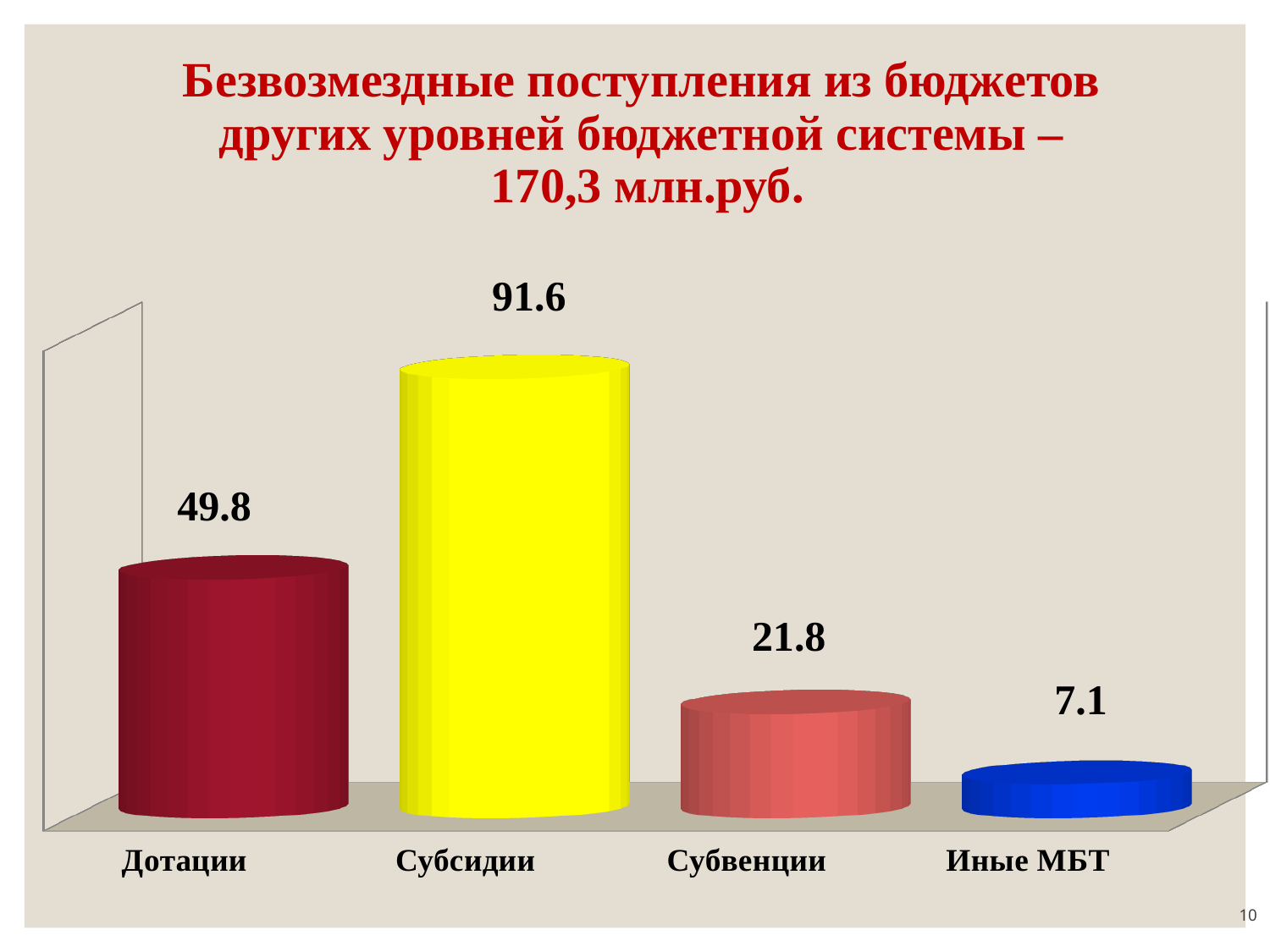
Which category has the highest value? Субсидии What is the value for Субсидии? 91.6 What is the value for Субвенции? 21.8 What kind of chart is shown on the slide? Bar chart Which category has the lowest value? Иные МБТ How many categories are shown in the chart? 4 What is the difference between the values for Субсидии and Дотации? 41.8 Which is larger, the value for Дотации or the value for Субвенции? Дотации What total amount in млн.руб. is stated in the chart title? 170,3 млн.руб. What is the value for Дотации? 49.8 What is the difference between the values for Субвенции and Иные МБТ? 14.7 What is the value for Иные МБТ? 7.1